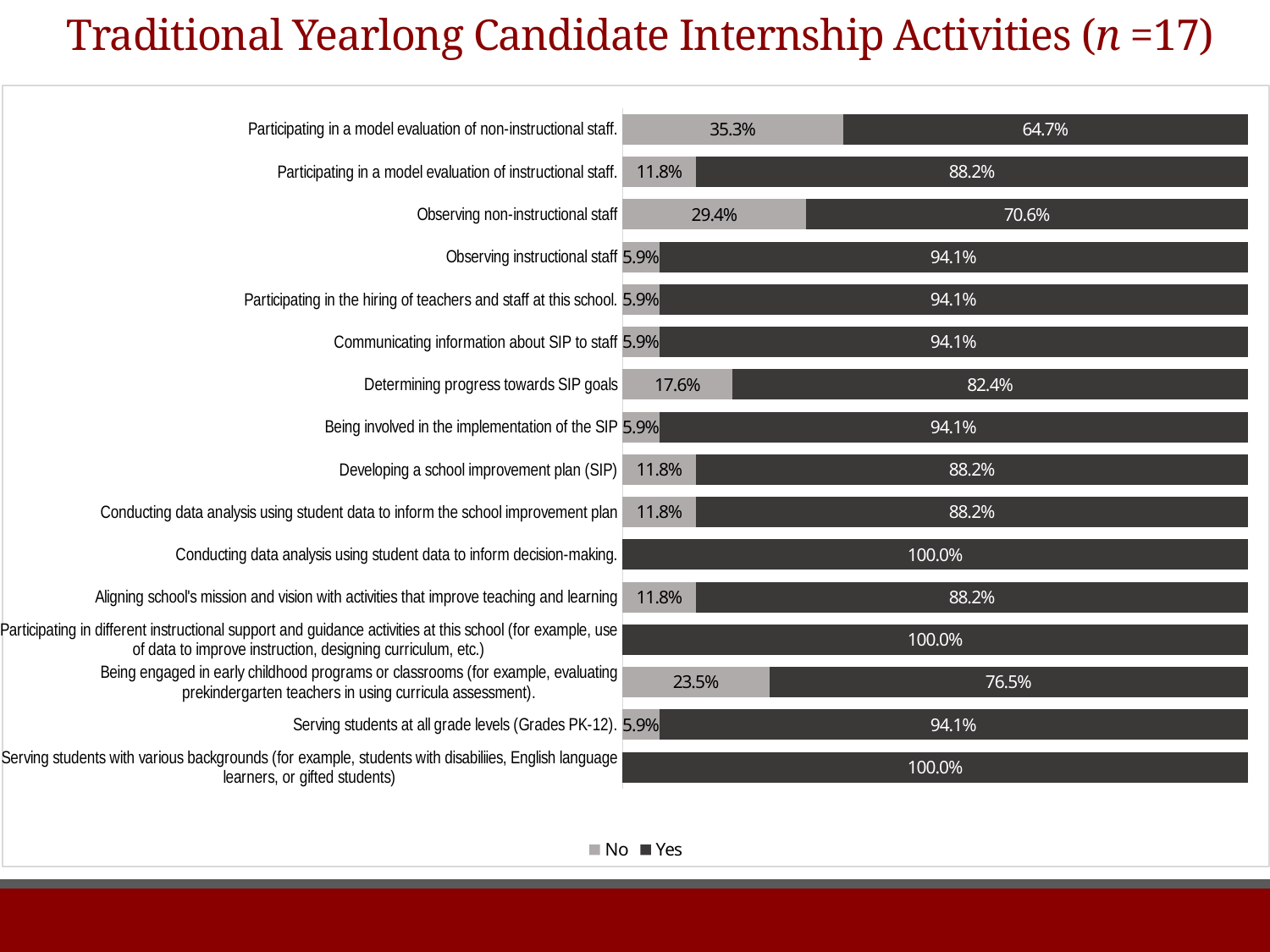
Which has a larger Yes percentage: "Developing a school improvement plan (SIP)" or "Determining progress towards SIP goals"? Developing a school improvement plan (SIP) How many activities are listed in the chart? 16 What is the sample size (n) given in the chart title? 17 Which activity has the highest No percentage? Participating in a model evaluation of non-instructional staff. What is the difference between the Yes percentages for "Observing instructional staff" and "Observing non-instructional staff"? 23.5% Which activity has the lowest Yes percentage? Participating in a model evaluation of non-instructional staff. What kind of chart is shown on the slide? Stacked bar chart What is the total of the No and Yes segments for "Participating in a model evaluation of instructional staff."? 100.0% What percentage of respondents answered No for "Determining progress towards SIP goals"? 17.6% What percentage of respondents answered Yes for "Observing non-instructional staff"? 70.6% How many series does the legend list? 2 What is the Yes percentage for "Being engaged in early childhood programs or classrooms"? 76.5%